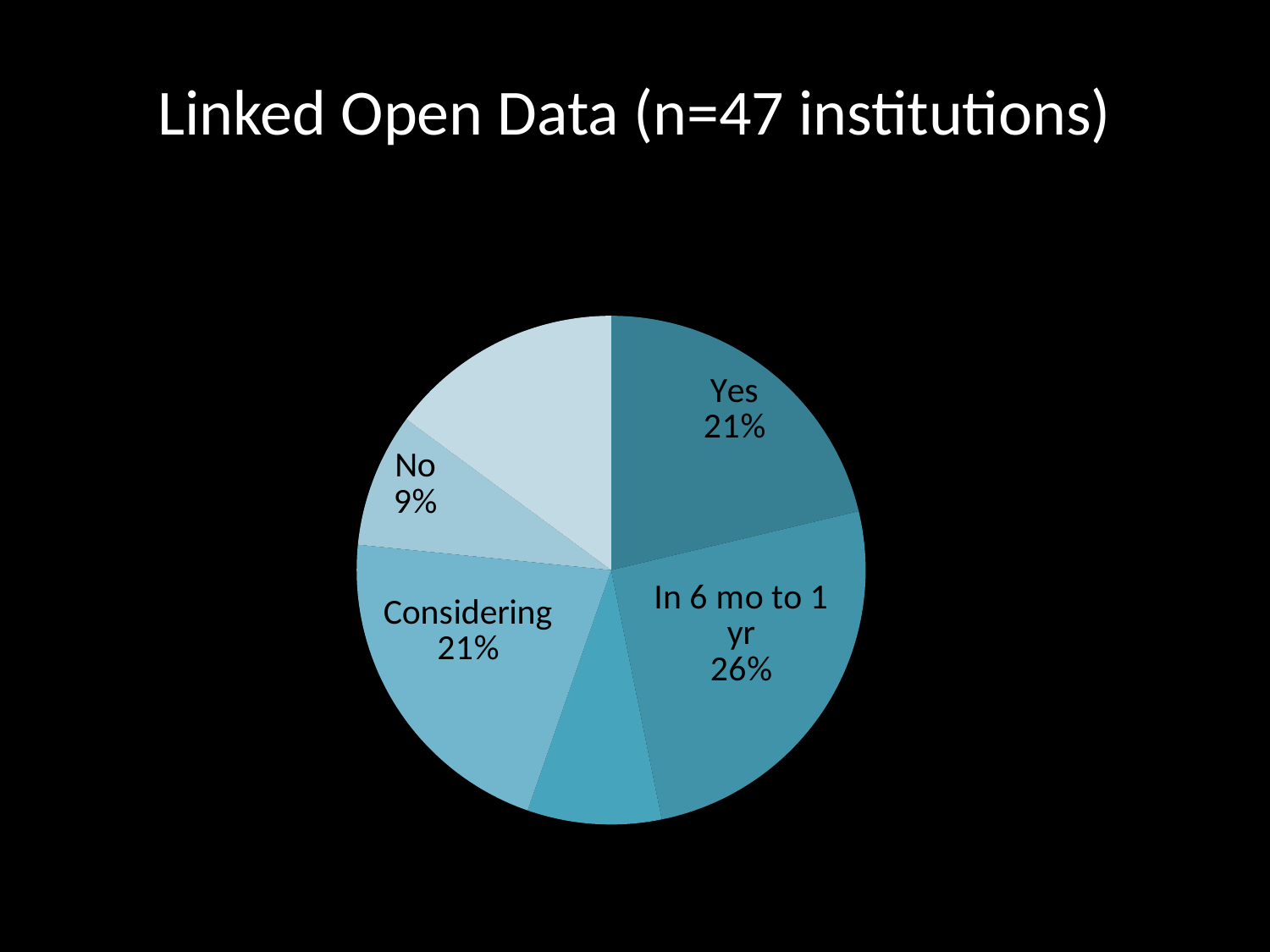
What is the difference in percentage points between "In 6 mo to 1 yr" and "Yes"? 5 percentage points Which slice of the pie is the largest? In 6 mo to 1 yr What percentage is shown for "In 6 mo to 1 yr"? 26% What kind of chart is shown on the slide? Pie chart What share of the pie does the "Yes" slice represent? 21% What is the title of the slide? Linked Open Data (n=47 institutions) What share of the pie does the "No" slice represent? 9% What percentage is shown for "Considering"? 21% How many institutions does the title say were surveyed? 47 Which is larger, the "Considering" slice or the "In 6 mo to 1 yr" slice? In 6 mo to 1 yr How many slices does the pie chart have? 6 Which is larger, the "Yes" slice or the "No" slice? Yes